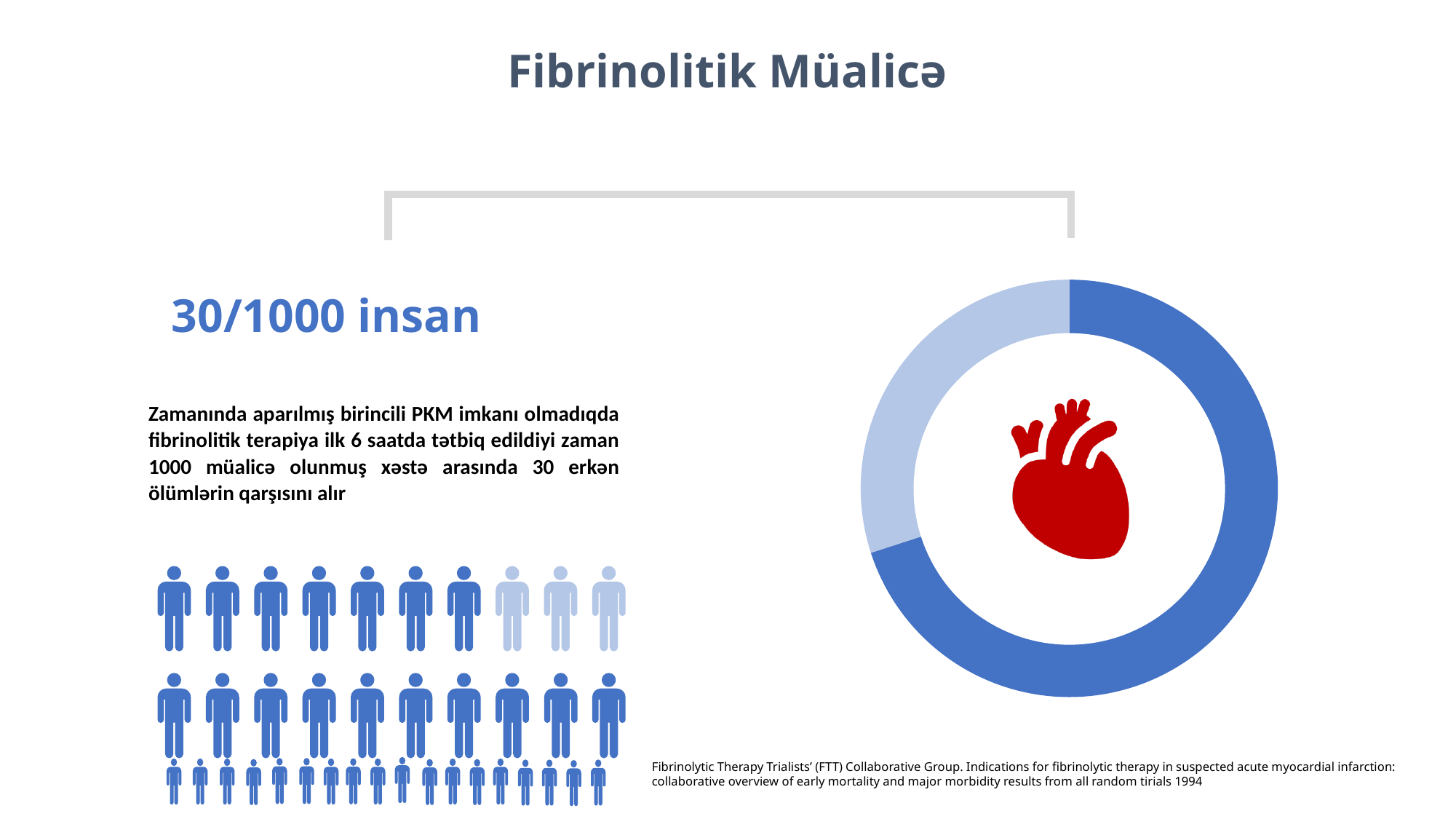
In the doughnut chart on the right, which segment is the smallest? The light blue segment How many segments does the doughnut chart on the right have? 2 What two colours are used for the segments of the doughnut chart? Dark blue and light blue What kind of chart is shown on the right side of the slide? Doughnut (pie) chart What icon is shown in the centre of the doughnut chart? A red heart In the doughnut chart on the right, which segment is larger, the dark blue one or the light blue one? The dark blue one